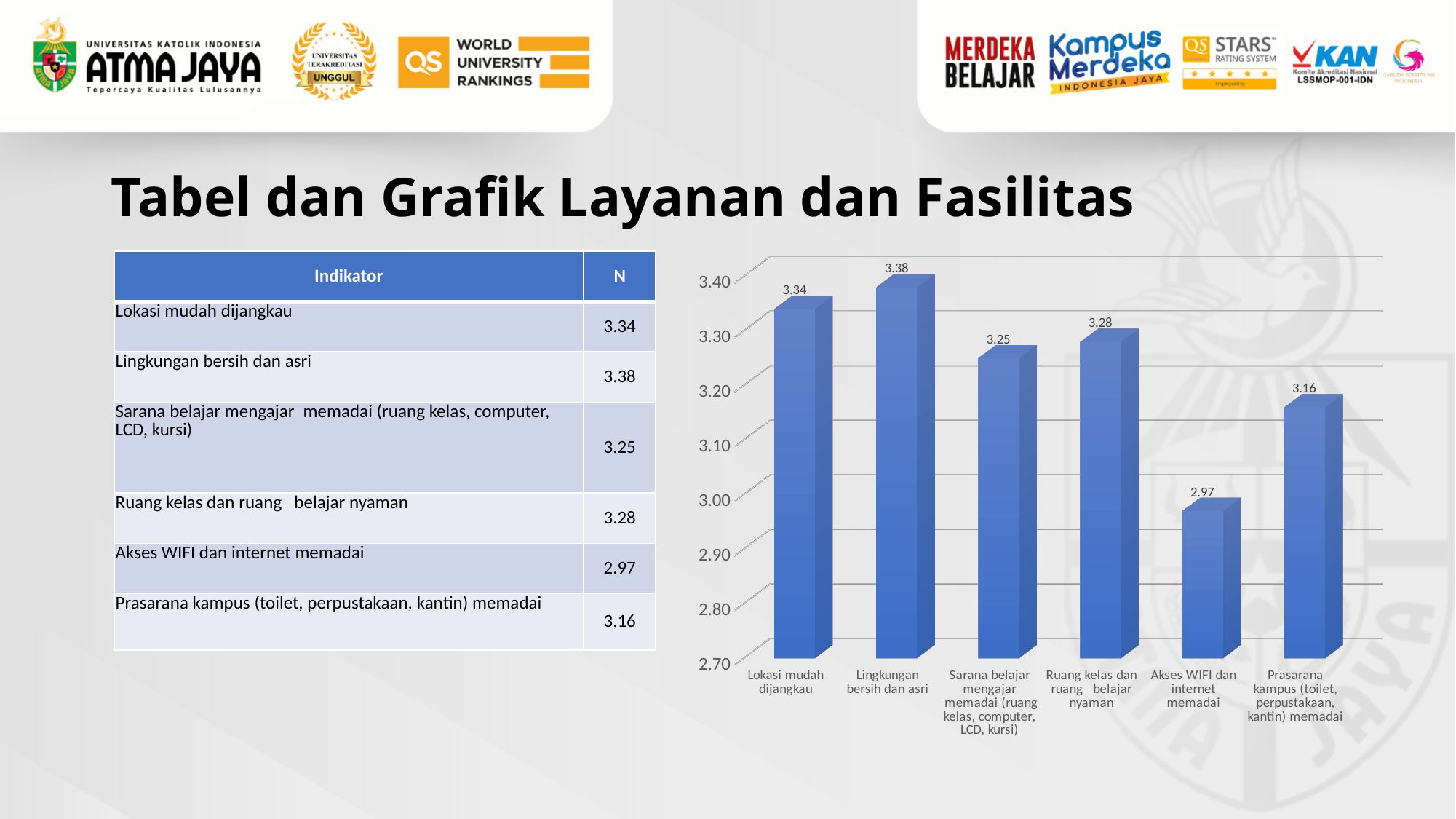
What is the difference between the values for Lingkungan bersih dan asri and Akses WIFI dan internet memadai? 0.41 What is the value for Akses WIFI dan internet memadai in the chart? 2.97 Which category has the highest value in the chart? Lingkungan bersih dan asri What is the lowest value shown on the chart's vertical axis? 2.70 How many categories are shown in the chart? 6 What is the difference between the values for Lokasi mudah dijangkau and Sarana belajar mengajar memadai (ruang kelas, computer, LCD, kursi)? 0.09 Which category has the lowest value in the chart? Akses WIFI dan internet memadai What is the value for Lokasi mudah dijangkau in the chart? 3.34 What kind of chart is shown on the slide? bar chart Which is larger: the value for Ruang kelas dan ruang belajar nyaman or the value for Prasarana kampus (toilet, perpustakaan, kantin) memadai? Ruang kelas dan ruang belajar nyaman What is the value for Prasarana kampus (toilet, perpustakaan, kantin) memadai in the chart? 3.16 Is the value for Akses WIFI dan internet memadai greater or less than 3.00? less